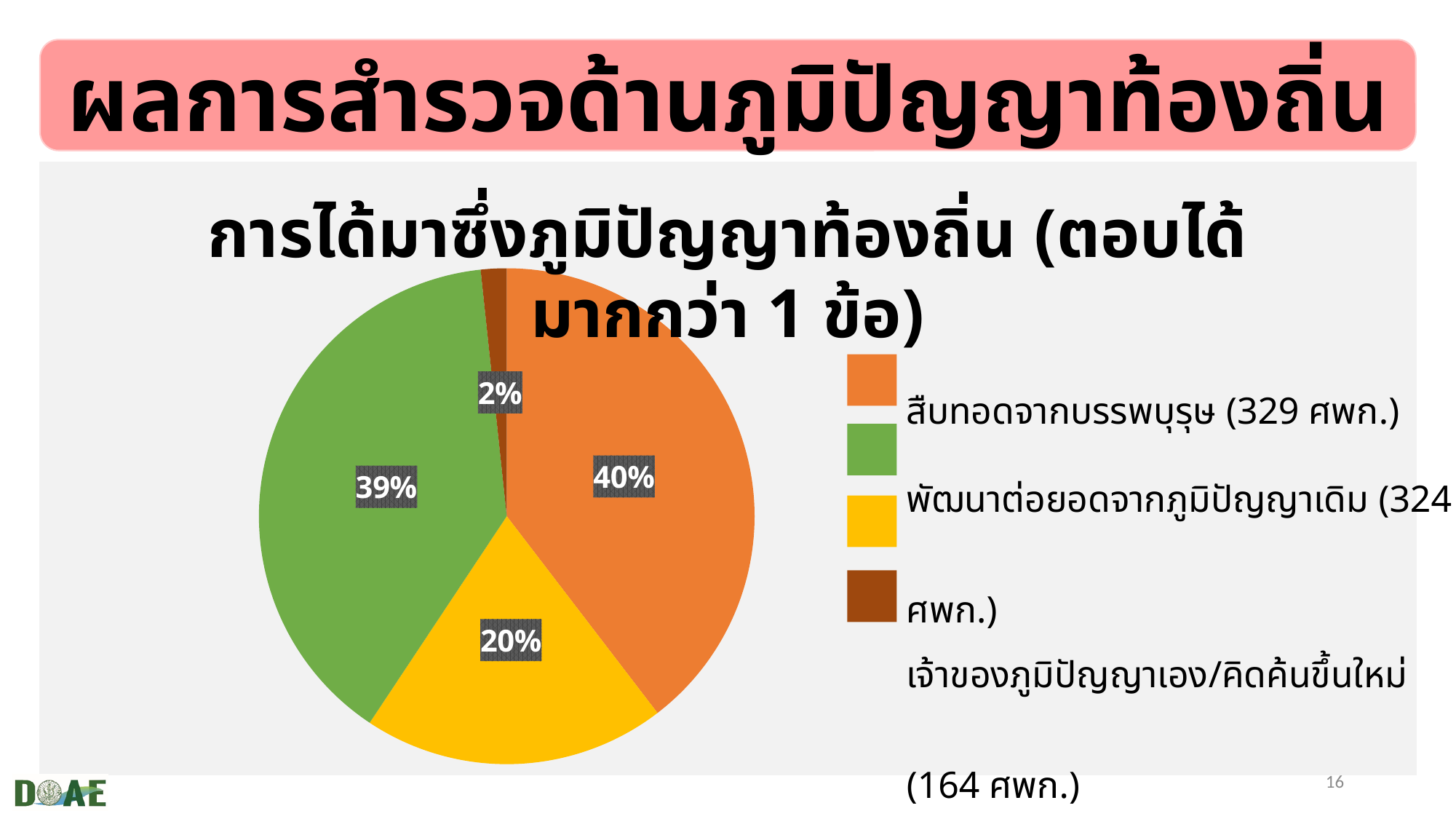
What type of chart is shown on the slide? Pie chart What is the difference in percentage points between the สืบทอดจากบรรพบุรุษ slice and the เจ้าของภูมิปัญญาเอง/คิดค้นขึ้นใหม่ slice? 20 percentage points What percentage of the pie does สืบทอดจากบรรพบุรุษ represent? 40% Which slice is larger: พัฒนาต่อยอดจากภูมิปัญญาเดิม or เจ้าของภูมิปัญญาเอง/คิดค้นขึ้นใหม่? พัฒนาต่อยอดจากภูมิปัญญาเดิม What colour is the slice for สืบทอดจากบรรพบุรุษ? Orange What percentage of the pie does เจ้าของภูมิปัญญาเอง/คิดค้นขึ้นใหม่ represent? 20% What is the smallest percentage shown on the pie chart? 2% How many ศพก. are given in the legend for สืบทอดจากบรรพบุรุษ? 329 ศพก. Which category has the largest slice of the pie? สืบทอดจากบรรพบุรุษ What percentage of the pie does พัฒนาต่อยอดจากภูมิปัญญาเดิม represent? 39% How many slices does the pie chart have? 4